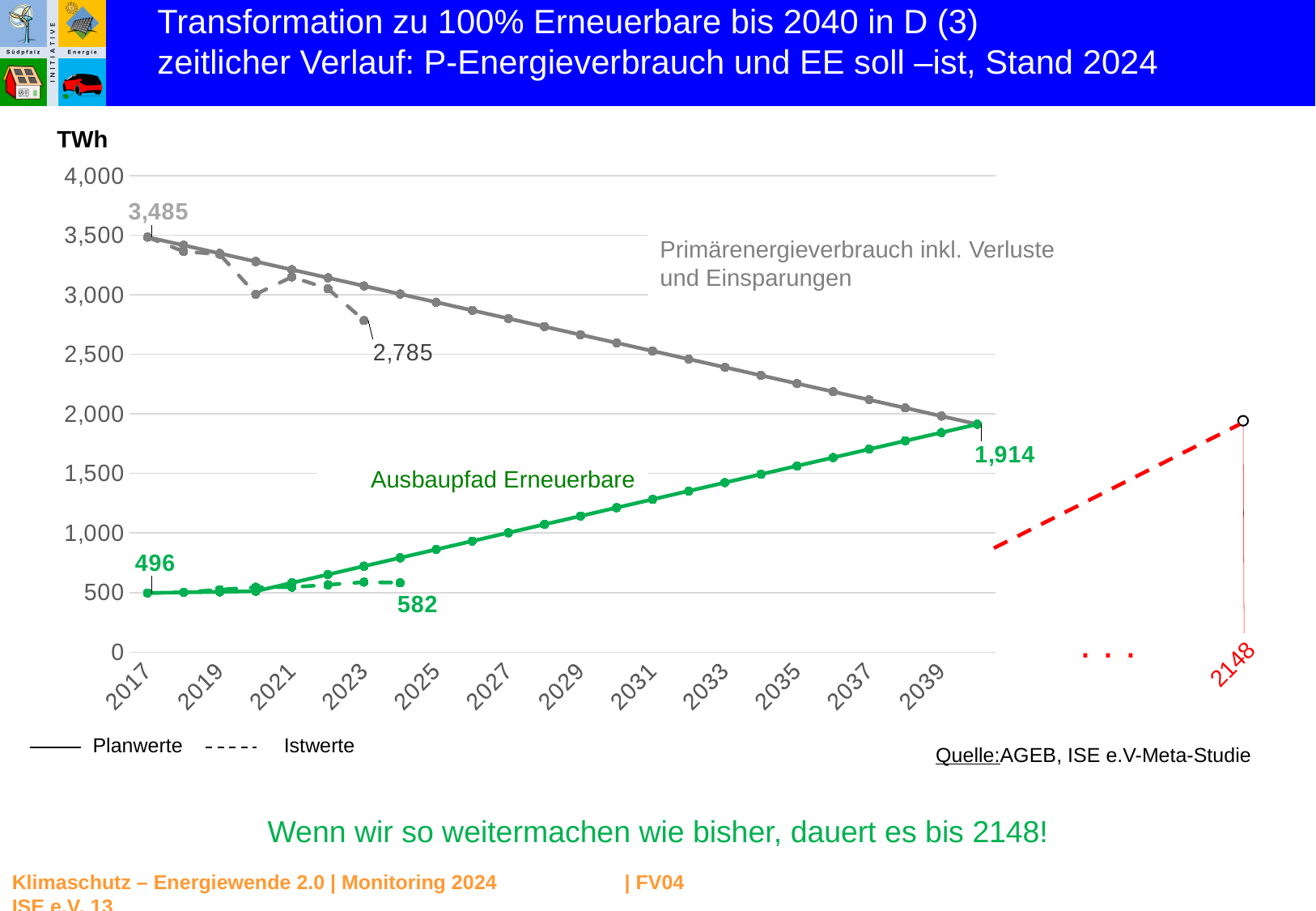
Is the planned Primärenergieverbrauch value in 2035 greater or less than 2,500? less Does the planned Primärenergieverbrauch line rise or fall from 2017 to 2039? fall Is the planned Ausbaupfad Erneuerbare value in 2031 greater or less than 1,000? greater What is the difference between the 2017 Primärenergieverbrauch value (3,485) and the 2017 Ausbaupfad Erneuerbare value (496)? 2,989 What unit is shown on the y axis of the chart? TWh What is the labelled Istwert for Primärenergieverbrauch on the grey dashed line? 2,785 What is the value of Primärenergieverbrauch inkl. Verluste und Einsparungen in 2017? 3,485 What is the value of the Ausbaupfad Erneuerbare in 2017? 496 What kind of chart is shown on the slide? line chart What is the latest labelled Istwert for the Erneuerbare (green dashed line)? 582 By how much does the planned Primärenergieverbrauch fall from 3,485 in 2017 to 1,914 at the end of the path? 1,571 At what value do the Primärenergieverbrauch line and the Ausbaupfad Erneuerbare line meet at the end of the planned path? 1,914